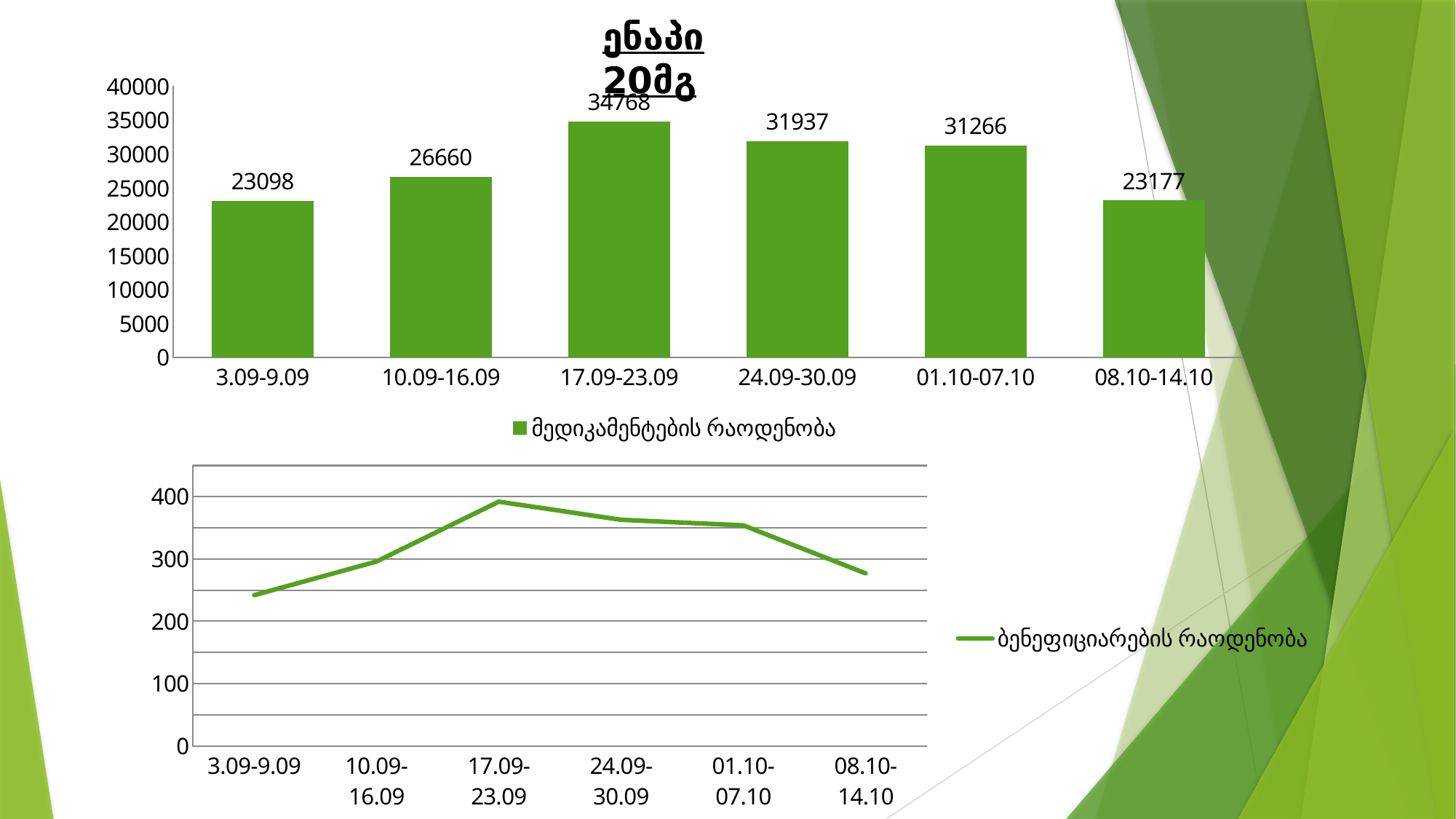
What type of chart is the bottom chart on the slide? Line chart How many periods are shown in the top bar chart? 6 In the top bar chart, which period has the lowest value? 3.09-9.09 In the top bar chart, which is larger, the value for 24.09-30.09 or 01.10-07.10? 24.09-30.09 What is the title of the top bar chart? ენაპი 20მგ What type of chart is the top chart on the slide? Bar chart In the top bar chart, what is the value for 17.09-23.09? 34768 In the bottom line chart, is the value for 3.09-9.09 greater or less than 300? less In the top bar chart, what is the difference between the values for 17.09-23.09 and 3.09-9.09? 11670 In the top bar chart, what is the value for 01.10-07.10? 31266 In the bottom line chart, which period has the highest value? 17.09-23.09 In the top bar chart, which period has the highest value? 17.09-23.09